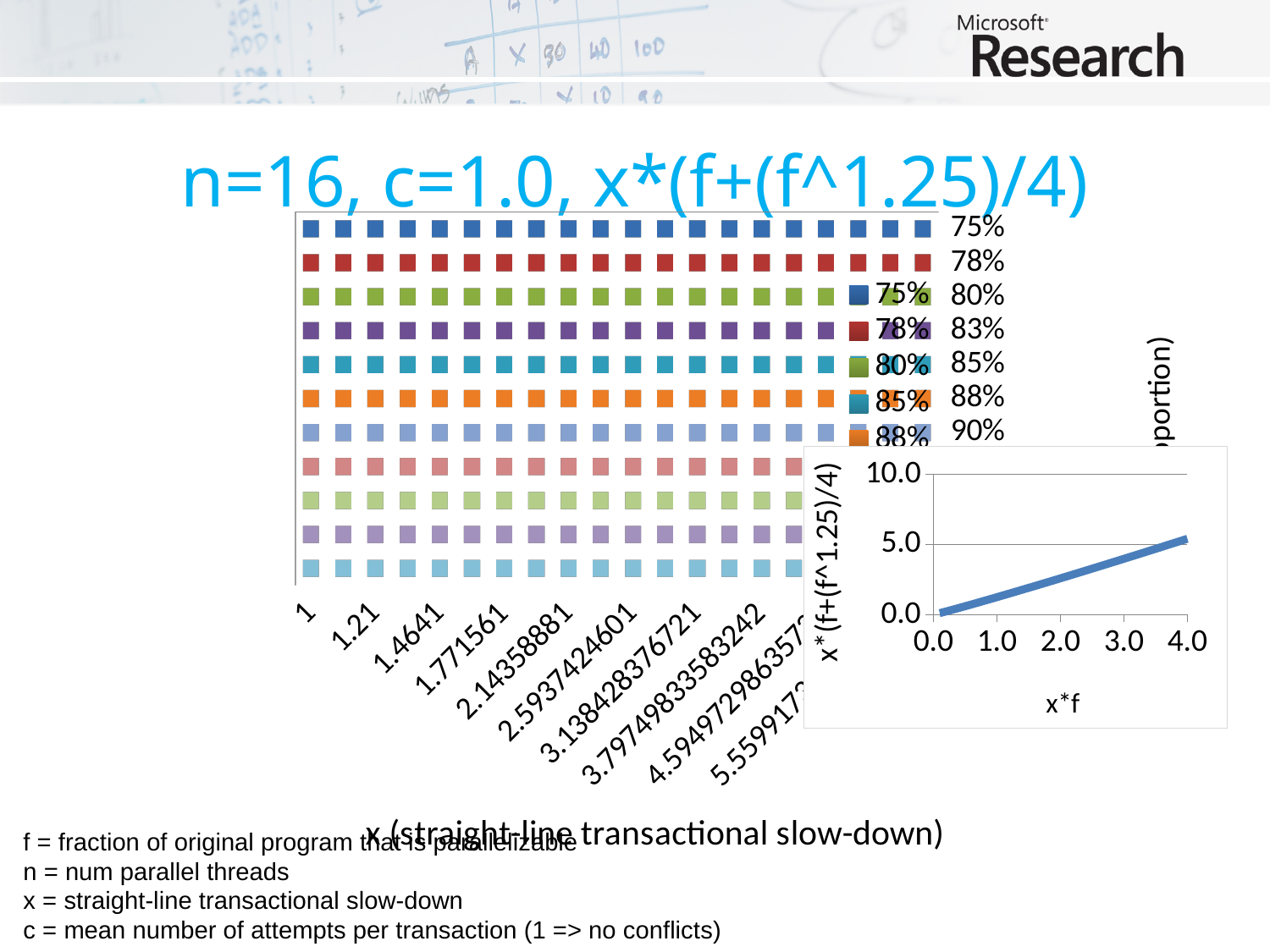
What is the first x-axis category label of the large chart on the left? 1 In the inset chart with x-axis x*f, is the value at x*f = 2.0 greater or less than 5.0? less In the inset chart with x-axis x*f, is the value at x*f = 4.0 greater or less than 10.0? less In the inset chart with x-axis x*f, do the values rise or fall as x*f increases? rise In the inset chart with x-axis x*f, is the value at x*f = 1.0 greater or less than 5.0? less What kind of chart is the small inset chart on the right (with axis title x*f)? line chart What is the x-axis title of the large chart on the left? x (straight-line transactional slow-down) What is the highest tick value shown on the y-axis of the inset chart on the right? 10.0